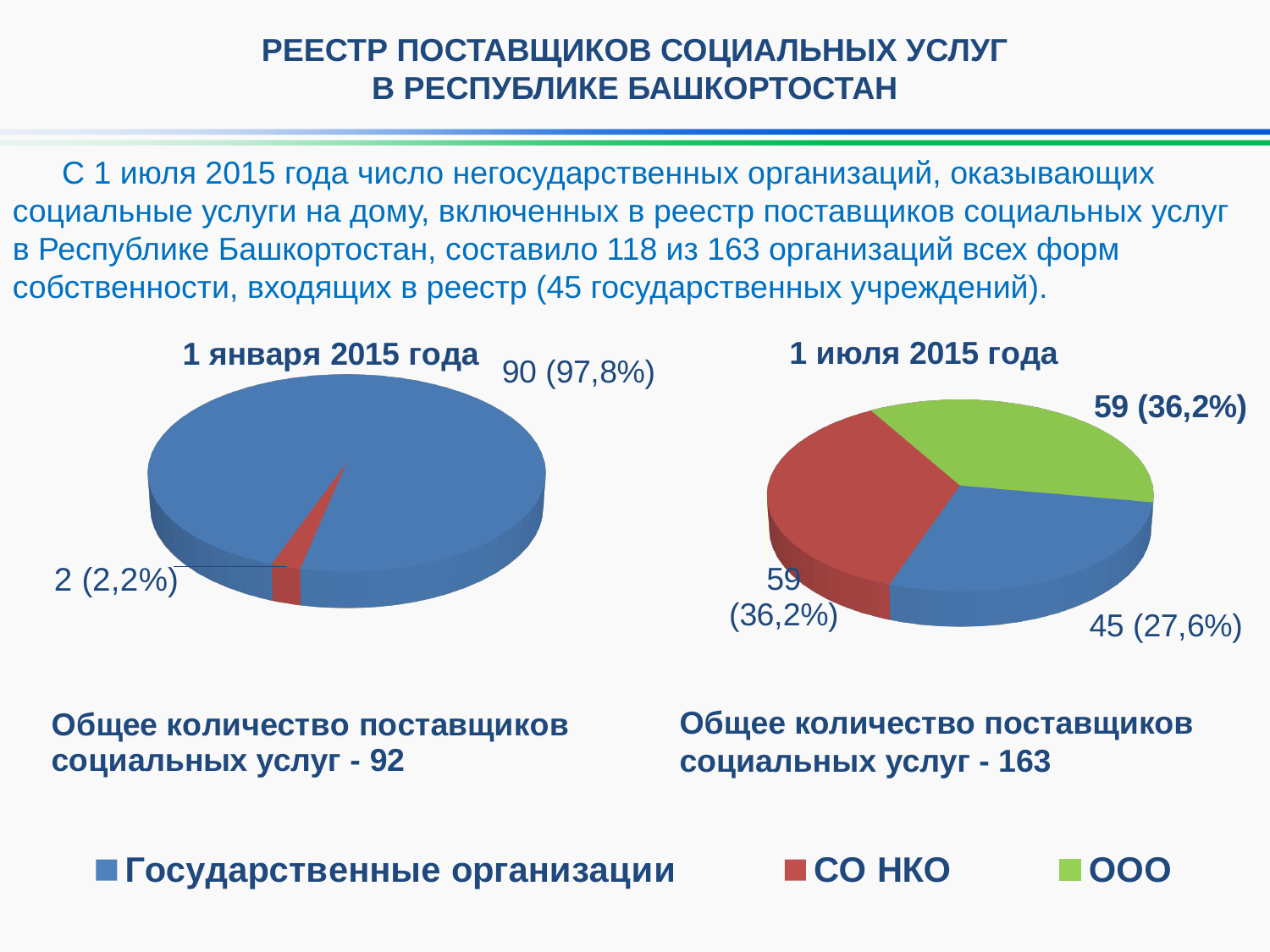
In the "1 января 2015 года" chart, what is the value for СО НКО? 2 (2,2%) In the "1 января 2015 года" chart, which category has the largest slice? Государственные организации In the "1 июля 2015 года" chart, what is the value for Государственные организации? 45 (27,6%) How many entries does the legend list? 3 In the "1 июля 2015 года" chart, which category has the smallest slice? Государственные организации In the "1 июля 2015 года" chart, what is the value for ООО? 59 (36,2%) In the "1 января 2015 года" chart, what is the value for Государственные организации? 90 (97,8%) What kind of chart is used for "1 января 2015 года"? pie chart How many slices does the "1 июля 2015 года" pie chart have? 3 In the "1 июля 2015 года" chart, what is the difference between the ООО value and the Государственные организации value? 14 Which colour represents ООО in the legend? green In the "1 июля 2015 года" chart, what share of the pie does СО НКО take? 36,2%